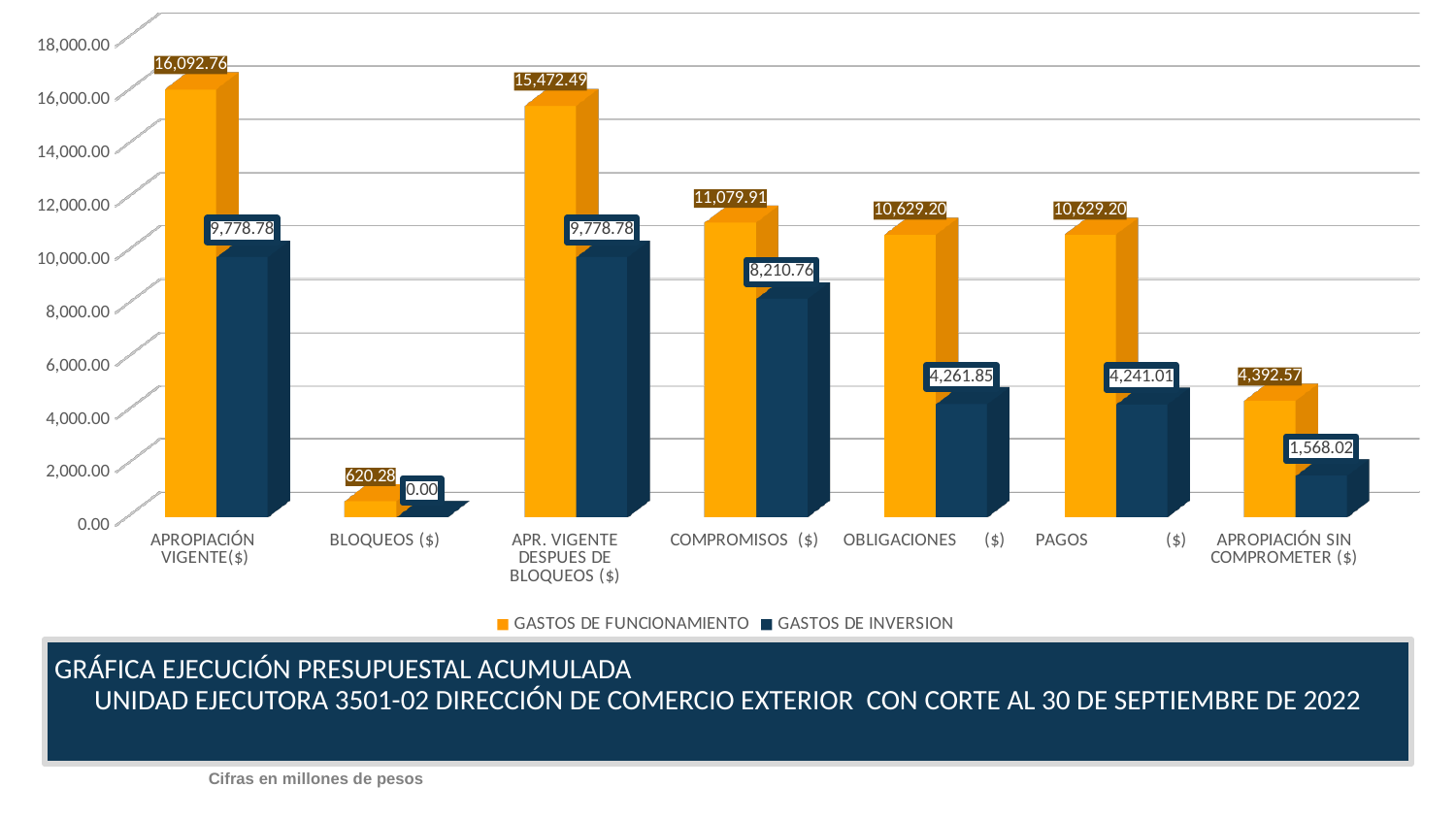
What is the difference between the GASTOS DE FUNCIONAMIENTO values for APROPIACIÓN VIGENTE($) and APR. VIGENTE DESPUES DE BLOQUEOS ($)? 620.27 Which category has the highest GASTOS DE FUNCIONAMIENTO value? APROPIACIÓN VIGENTE($) Which category has the lowest GASTOS DE INVERSION value? BLOQUEOS ($) What is the value of GASTOS DE INVERSION for OBLIGACIONES ($)? 4,261.85 How many series does the legend list? 2 What is the value of GASTOS DE FUNCIONAMIENTO for APROPIACIÓN SIN COMPROMETER ($)? 4,392.57 How many categories are shown on the x axis? 7 What is the value of GASTOS DE FUNCIONAMIENTO for COMPROMISOS ($)? 11,079.91 What kind of chart is shown on the slide? Bar chart Which is larger: GASTOS DE INVERSION for OBLIGACIONES ($) or GASTOS DE INVERSION for APROPIACIÓN SIN COMPROMETER ($)? OBLIGACIONES ($) What is the value of GASTOS DE INVERSION for BLOQUEOS ($)? 0.00 What is the difference between GASTOS DE FUNCIONAMIENTO and GASTOS DE INVERSION for COMPROMISOS ($)? 2,869.15